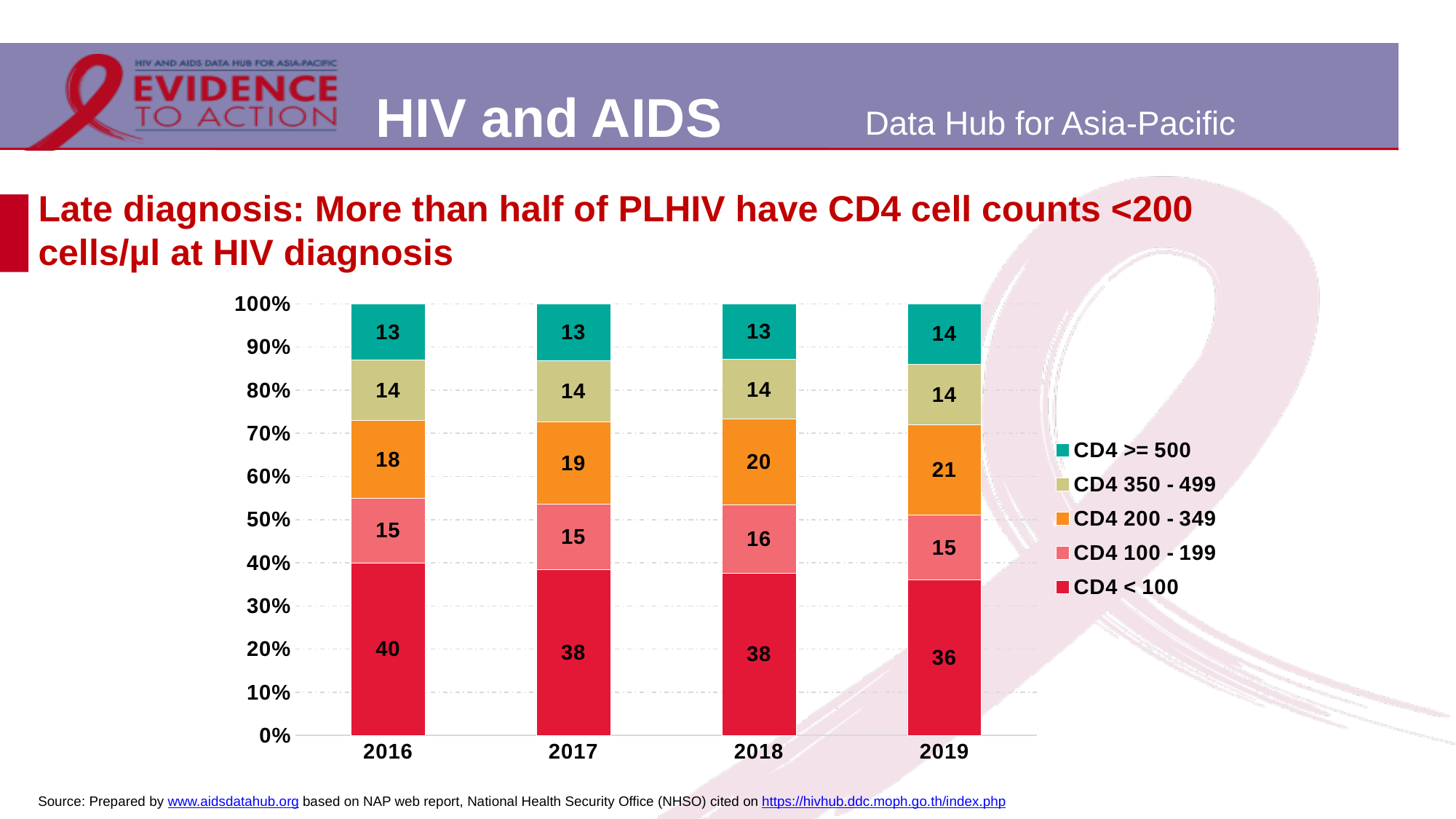
How many series does the legend list? 5 What is the value for CD4 < 100 in 2016? 40 What is the value for CD4 >= 500 in 2019? 14 Which is larger, the CD4 200 - 349 value in 2017 or in 2018? 2018 What is the difference between the CD4 < 100 values for 2016 and 2019? 4 How many years are shown on the x axis? 4 What is the value for CD4 100 - 199 in 2018? 16 In which year is the CD4 200 - 349 value lowest? 2016 Does the CD4 < 100 value rise or fall from 2016 to 2019? Fall In which year is the CD4 < 100 value highest? 2016 What is the value for CD4 200 - 349 in 2019? 21 What kind of chart is shown on the slide? Stacked bar chart